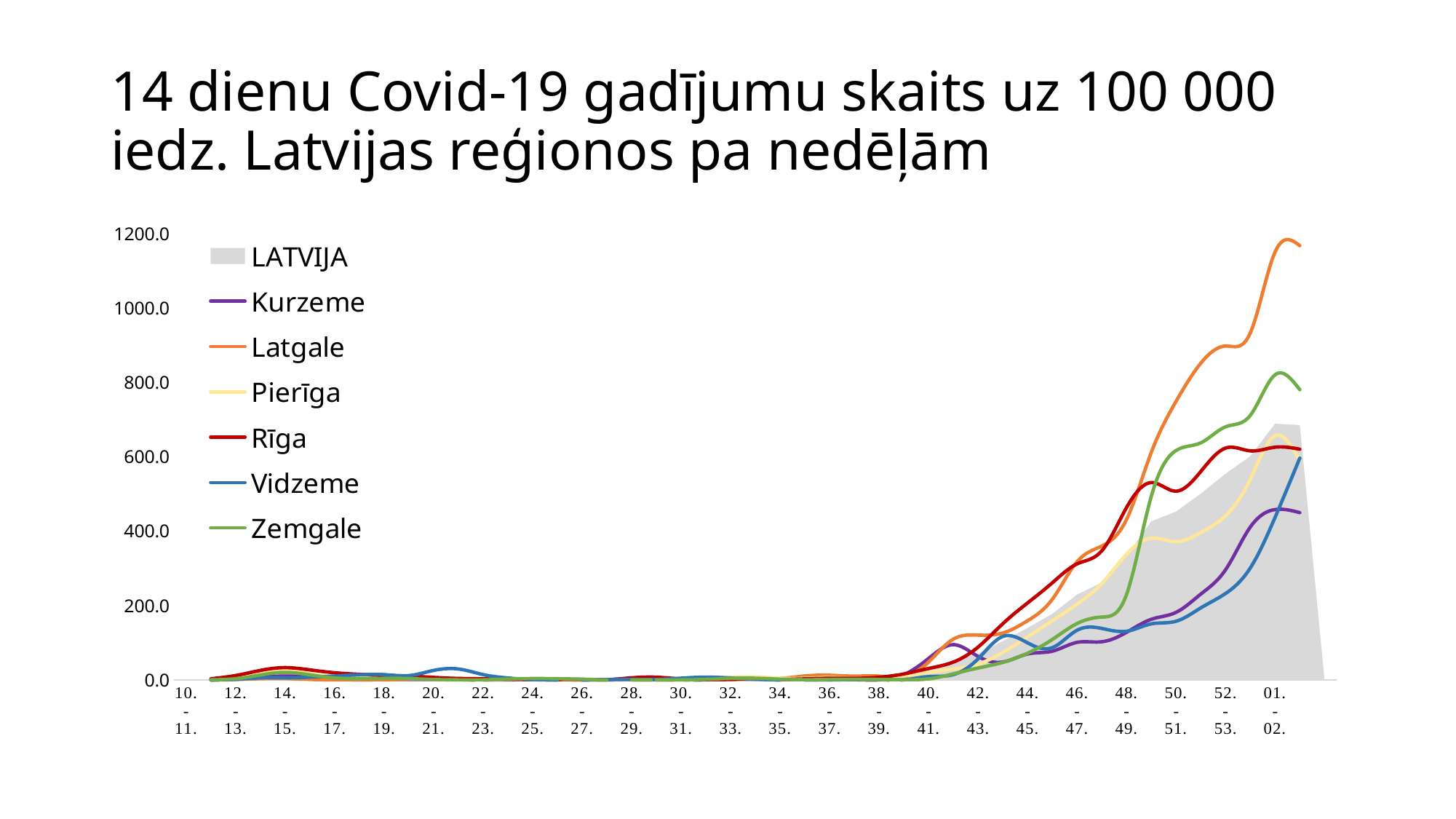
Is the value for Kurzeme at the last week greater or less than 600? less Which series is drawn as a shaded grey area rather than a line? LATVIJA Do the values generally rise or fall from week 40 onward along the x axis? rise Is the value for Zemgale at the last week greater or less than 600? greater What is the highest value shown on the y axis? 1200.0 At the right end of the chart, which is larger: the value for Latgale or the value for Kurzeme? Latgale Is the peak value for Latgale greater or less than 1000? greater What kind of chart is shown on the slide? combination area and line chart Which region's line is lowest at the right end of the chart? Kurzeme How many series does the legend list? 7 Which series reaches the highest value at the right end of the chart? Latgale